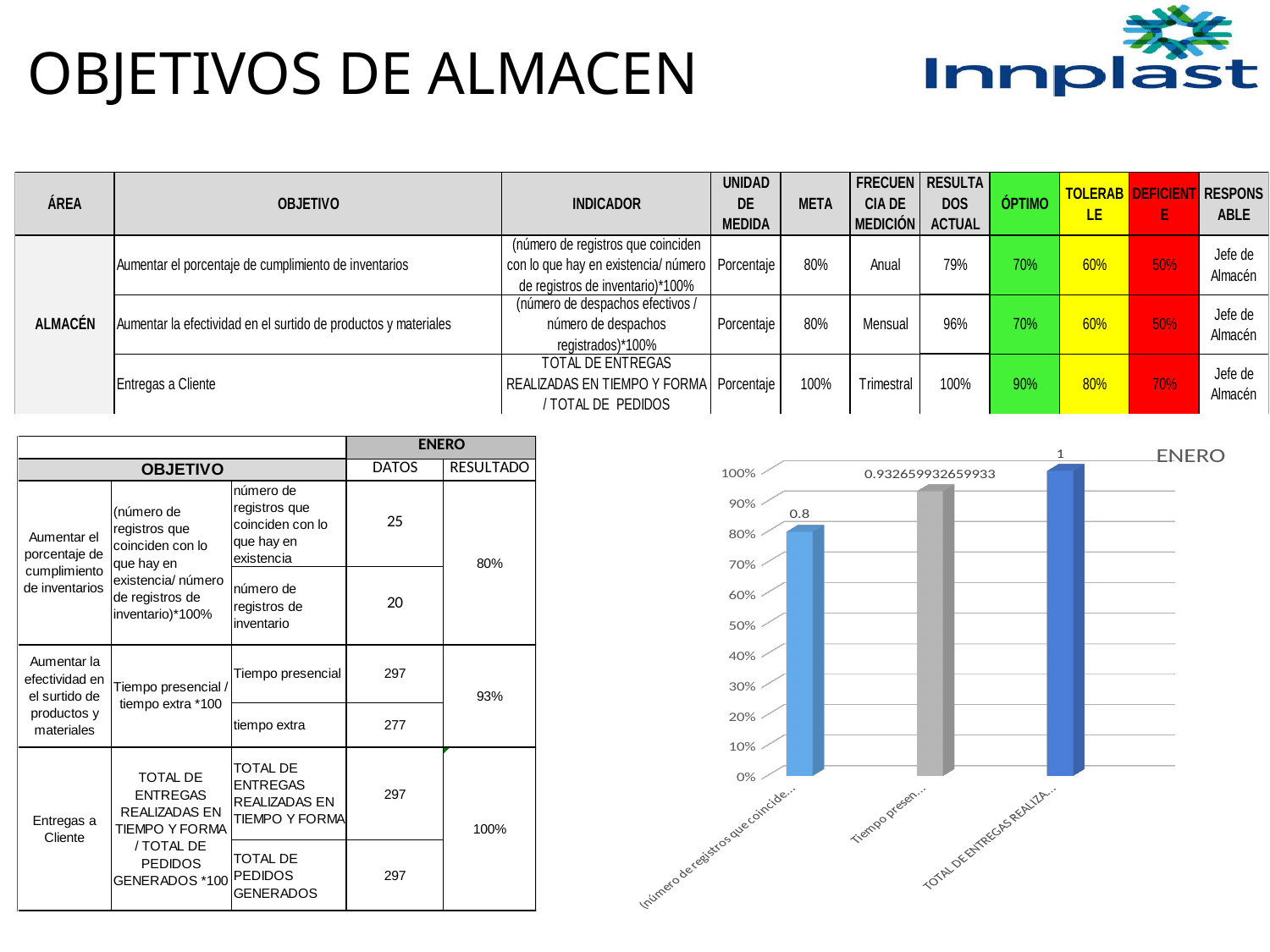
In the ENERO chart, do the bar values rise or fall from left to right? rise In the ENERO chart, is the value of the first bar (número de registros que coincide...) greater or less than 90%? less In the ENERO chart, which bar has the highest value? TOTAL DE ENTREGAS REALIZA... (third bar) In the ENERO chart, which bar has the lowest value? número de registros que coincide... (first bar) What is the title of the chart on the slide? ENERO In the ENERO chart, which is larger: the first bar (número de registros que coincide...) or the second bar (Tiempo presen...)? Tiempo presen... (second bar) In the ENERO chart, what is the data label on the second bar (Tiempo presen...)? 0.932659932659933 How many bars are plotted in the ENERO chart? 3 What kind of chart is shown on the slide? bar chart In the ENERO chart, what is the difference between the third bar (1) and the first bar (0.8)? 0.2 In the ENERO chart, what is the data label on the first bar (número de registros que coincide...)? 0.8 In the ENERO chart, what is the data label on the third bar (TOTAL DE ENTREGAS REALIZA...)? 1